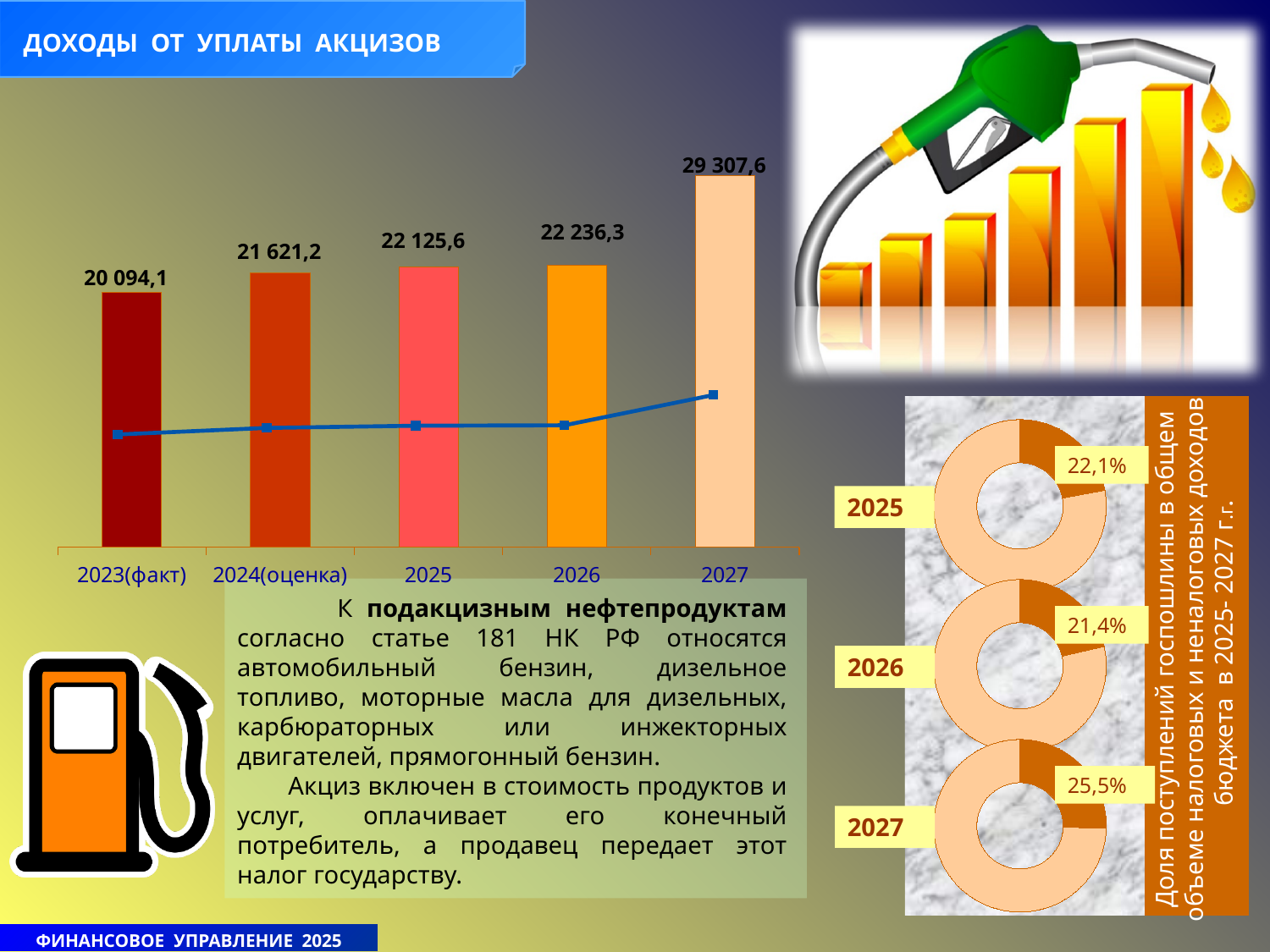
In the bar chart on the left, do the bar values rise or fall from 2023(факт) to 2027? rise In the bar chart on the left, which is larger: the value for 2025 or the value for 2027? 2027 In the bar chart on the left, which year has the highest value? 2027 In the bar chart on the left, how many categories are shown on the x axis? 5 In the bar chart on the left, what is the difference between the values for 2024(оценка) and 2023(факт)? 1 527,1 In the bar chart on the left, what is the value for 2027? 29 307,6 In the bar chart on the left, which category has the lowest value? 2023(факт) In the bar chart on the left, what is the difference between the values for 2027 and 2026? 7 071,3 In the bar chart on the left, what is the value for 2023(факт)? 20 094,1 In the donut charts on the right, what share is shown for 2026? 21,4% In the bar chart on the left, what is the value for 2024(оценка)? 21 621,2 In the donut charts on the right, which year shows the largest share? 2027